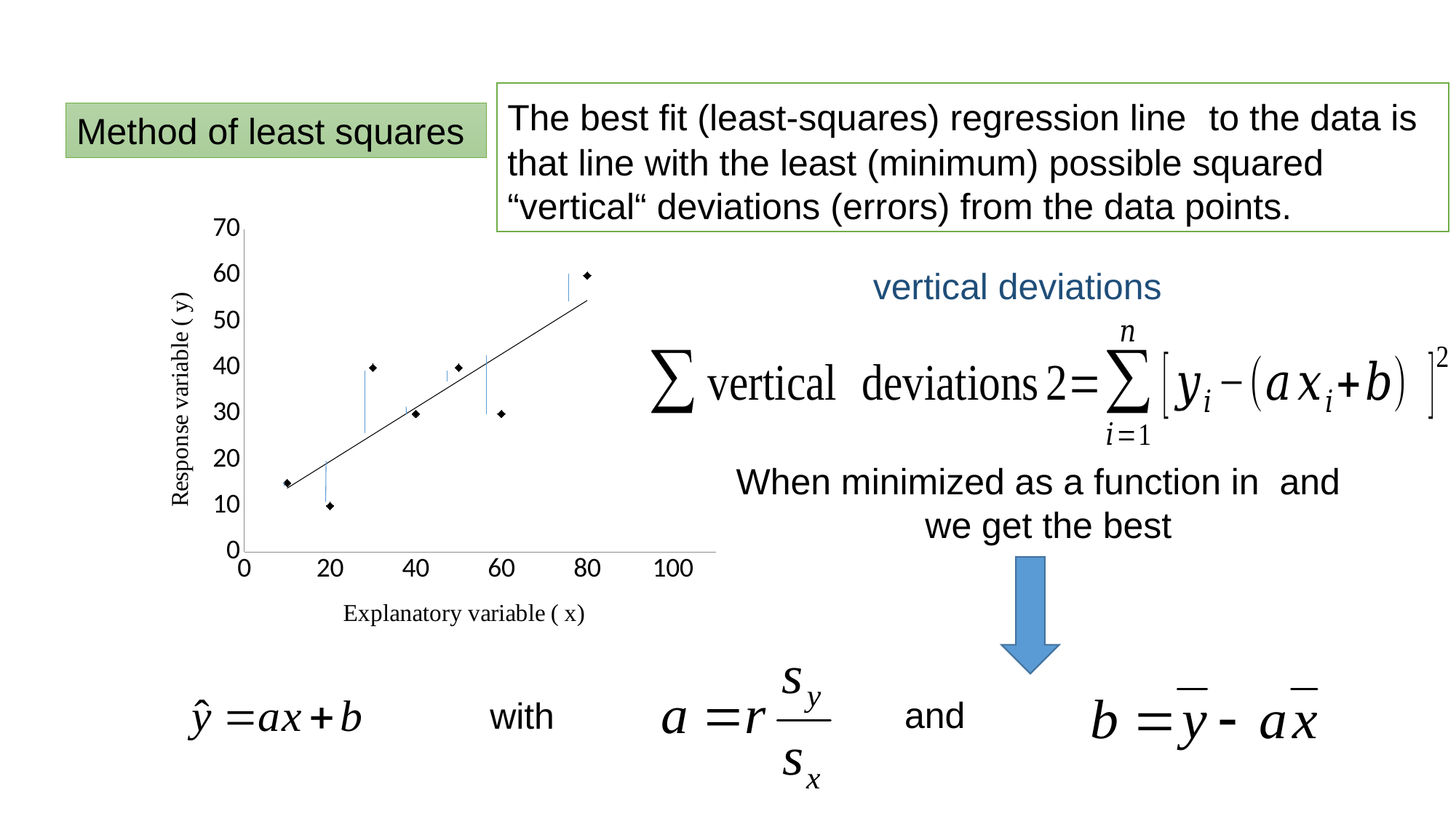
Is the response value of the data point at x = 30 greater or less than 30? greater Do the plotted values generally rise or fall as the explanatory variable increases? rise What is the title of the vertical axis of the chart? Response variable ( y) Is the response value of the lowest data point greater or less than 20? less What is the title of the horizontal axis of the chart? Explanatory variable ( x) Which has the larger response value: the data point at x = 20 or the data point at x = 80? the data point at x = 80 Is the explanatory value of the rightmost data point greater or less than 70? greater What is the largest value shown on the vertical axis of the chart? 70 What kind of chart is shown on the slide? scatter chart How many data points are plotted in the scatter chart? 7